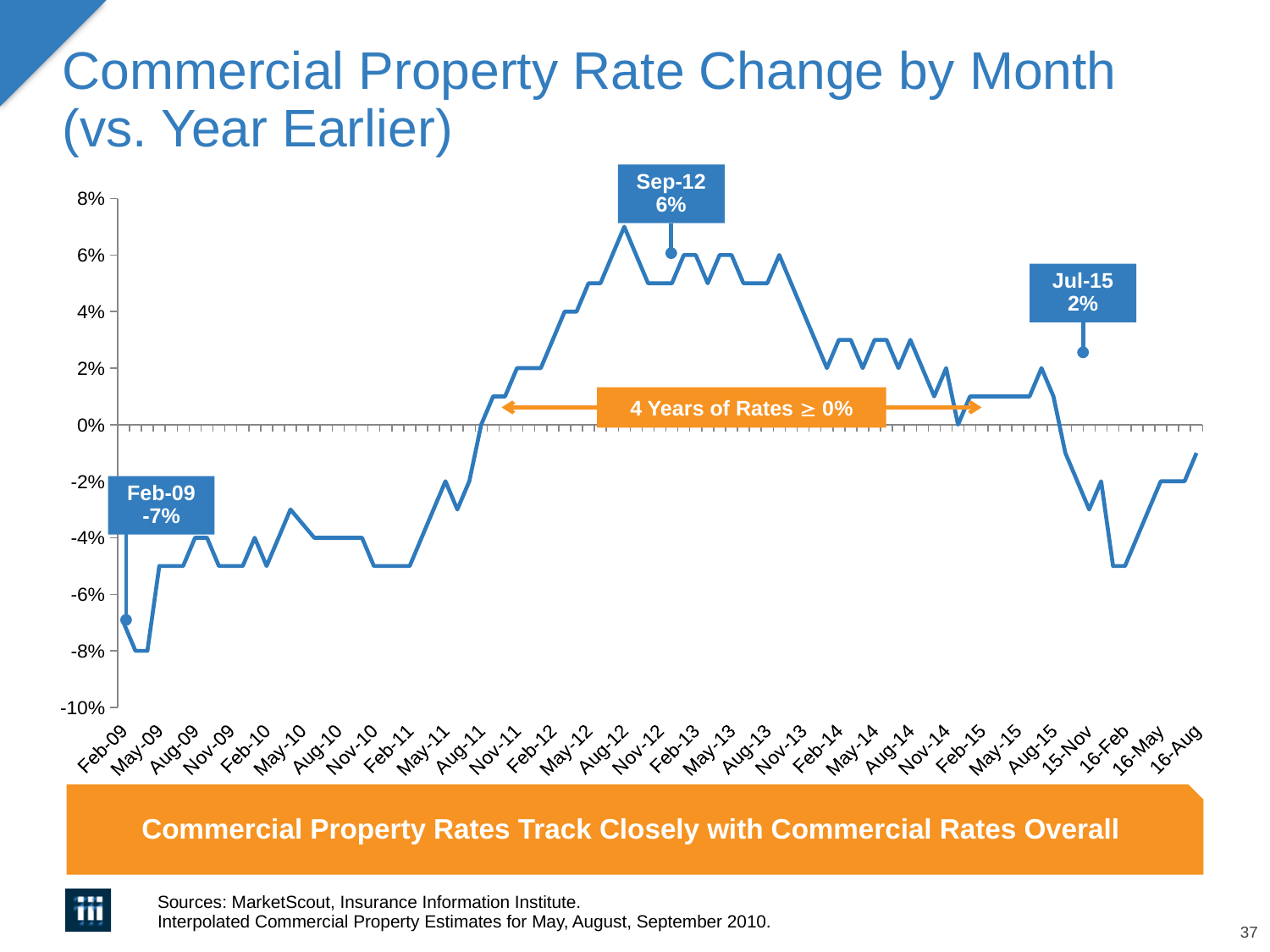
Is the value for Feb-14 greater or less than 0%? greater Which labeled point has the larger value, Sep-12 or Jul-15? Sep-12 Is the value for Feb-11 greater or less than 0%? less What is the commercial property rate change shown for Jul-15? 2% What does the orange annotation in the middle of the chart say? 4 Years of Rates ≥ 0% Does the rate change generally rise or fall between Feb-09 and Sep-12? Rise Of the three labeled points (Feb-09, Sep-12, Jul-15), which has the lowest value? Feb-09 What kind of chart is shown on the slide? Line chart By how many percentage points does the labeled Sep-12 value exceed the labeled Feb-09 value? 13 percentage points What is the commercial property rate change shown for Feb-09? -7% Of the three labeled points (Feb-09, Sep-12, Jul-15), which has the highest value? Sep-12 What is the commercial property rate change shown for Sep-12? 6%